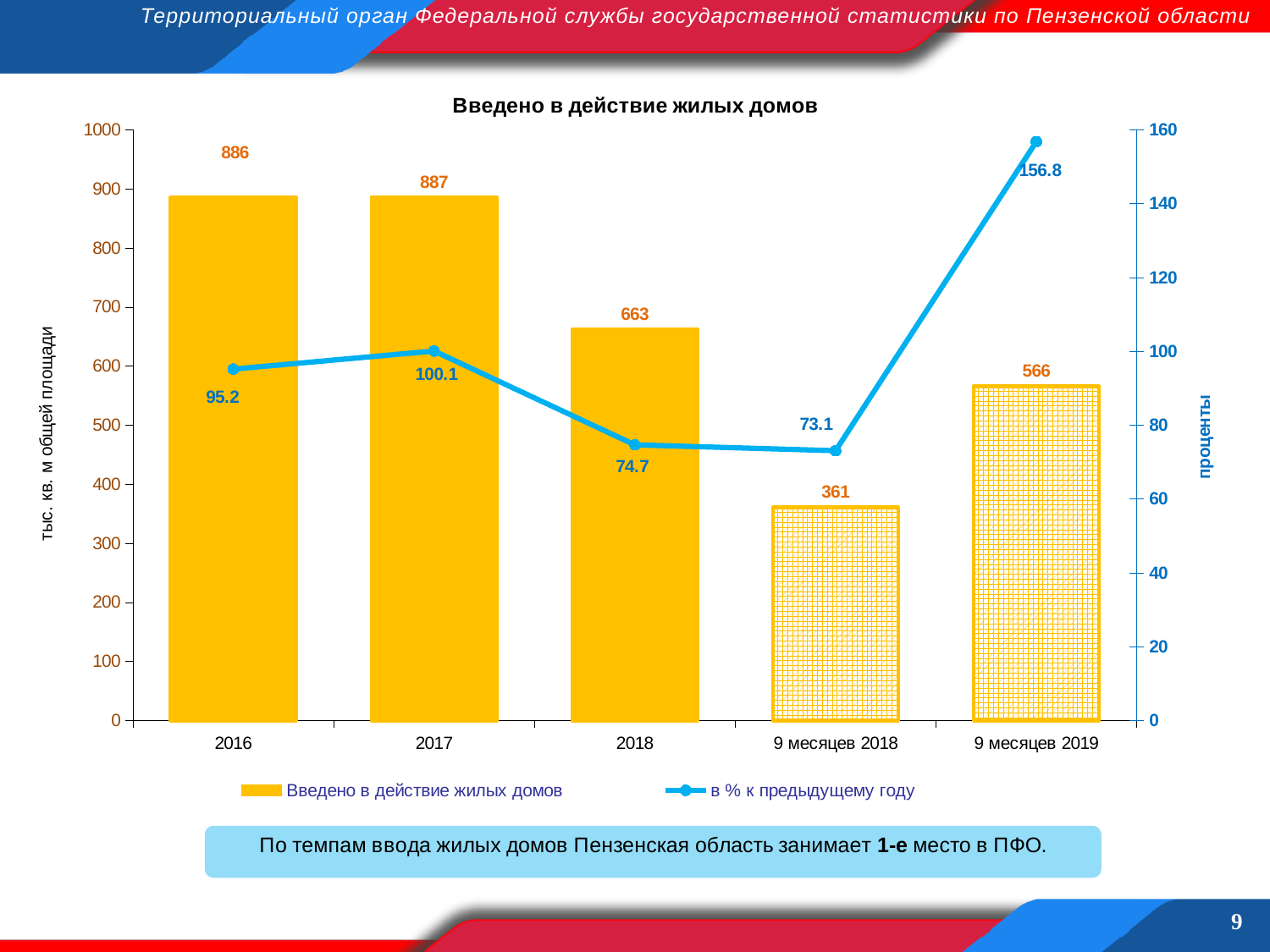
Which category has the lowest bar value? 9 месяцев 2018 What is the value of the line series "в % к предыдущему году" for 9 месяцев 2019? 156.8 What is the value of the bar for 2017 in the chart "Введено в действие жилых домов"? 887 How many series does the legend list? 2 What is the bar value for 9 месяцев 2018? 361 Which category has the highest value on the line "в % к предыдущему году"? 9 месяцев 2019 What is the difference between the bar values for 2017 and 2018? 224 Which is larger: the bar value for 9 месяцев 2019 or for 2018? 2018 How many categories are shown on the x axis? 5 What kind of chart is shown on the slide? Combined bar and line chart What is the title of the chart? Введено в действие жилых домов Is the line value for 2018 greater or less than 80? less